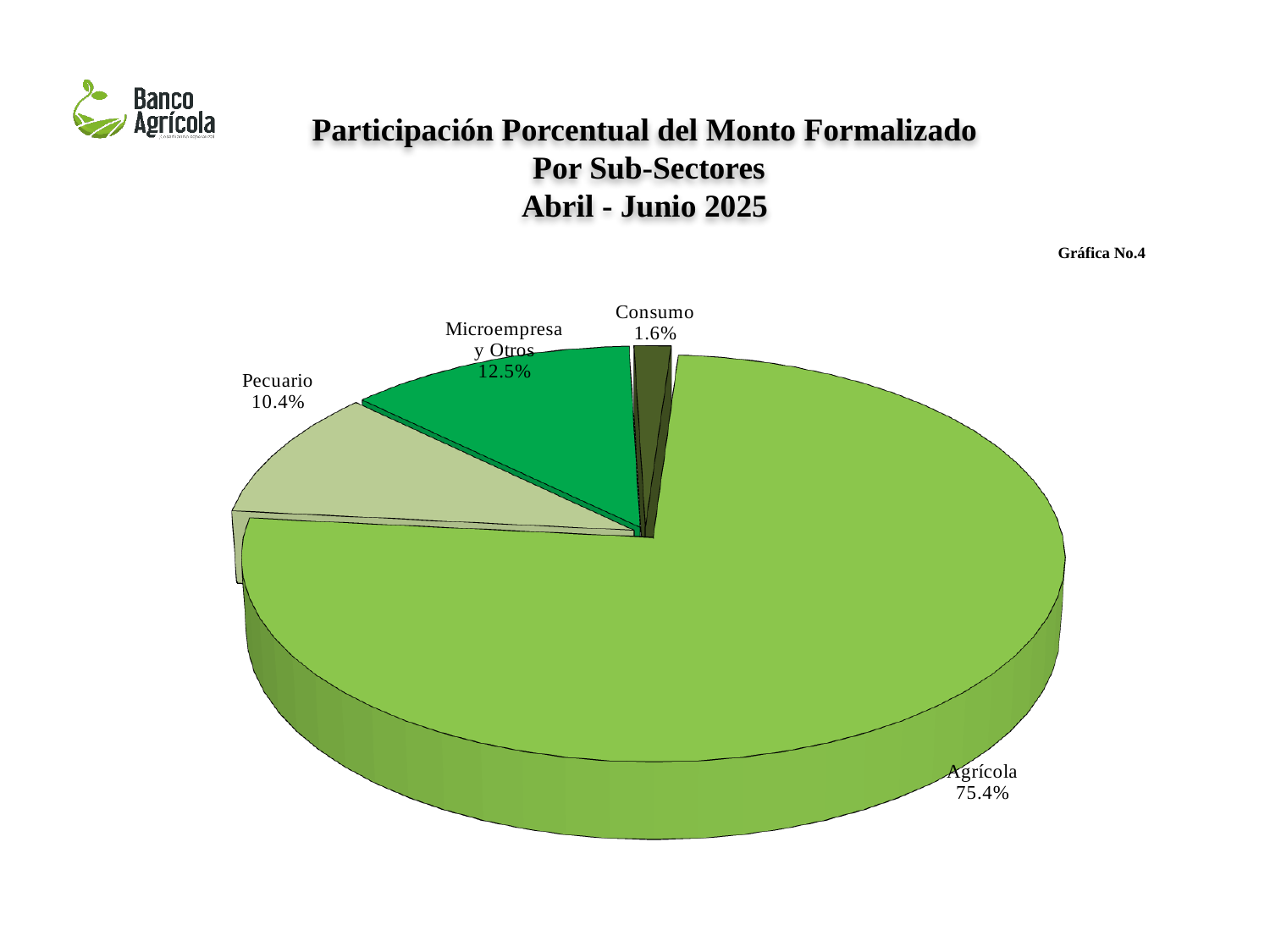
How many sub-sectors are shown in the pie chart? 4 What is the difference in percentage points between Agrícola and Consumo? 73.8 Which sub-sector has the smallest share of the pie? Consumo Which is larger, the share for Pecuario or the share for Microempresa y Otros? Microempresa y Otros What is the value shown for Pecuario? 10.4% What is the difference in percentage points between Microempresa y Otros and Pecuario? 2.1 What is the value shown for Consumo? 1.6% What is the value shown for Microempresa y Otros? 12.5% What period does the chart title refer to? Abril - Junio 2025 What kind of chart is shown on the slide? Pie chart Which sub-sector has the largest share of the pie? Agrícola What share of the pie does Agrícola hold? 75.4%